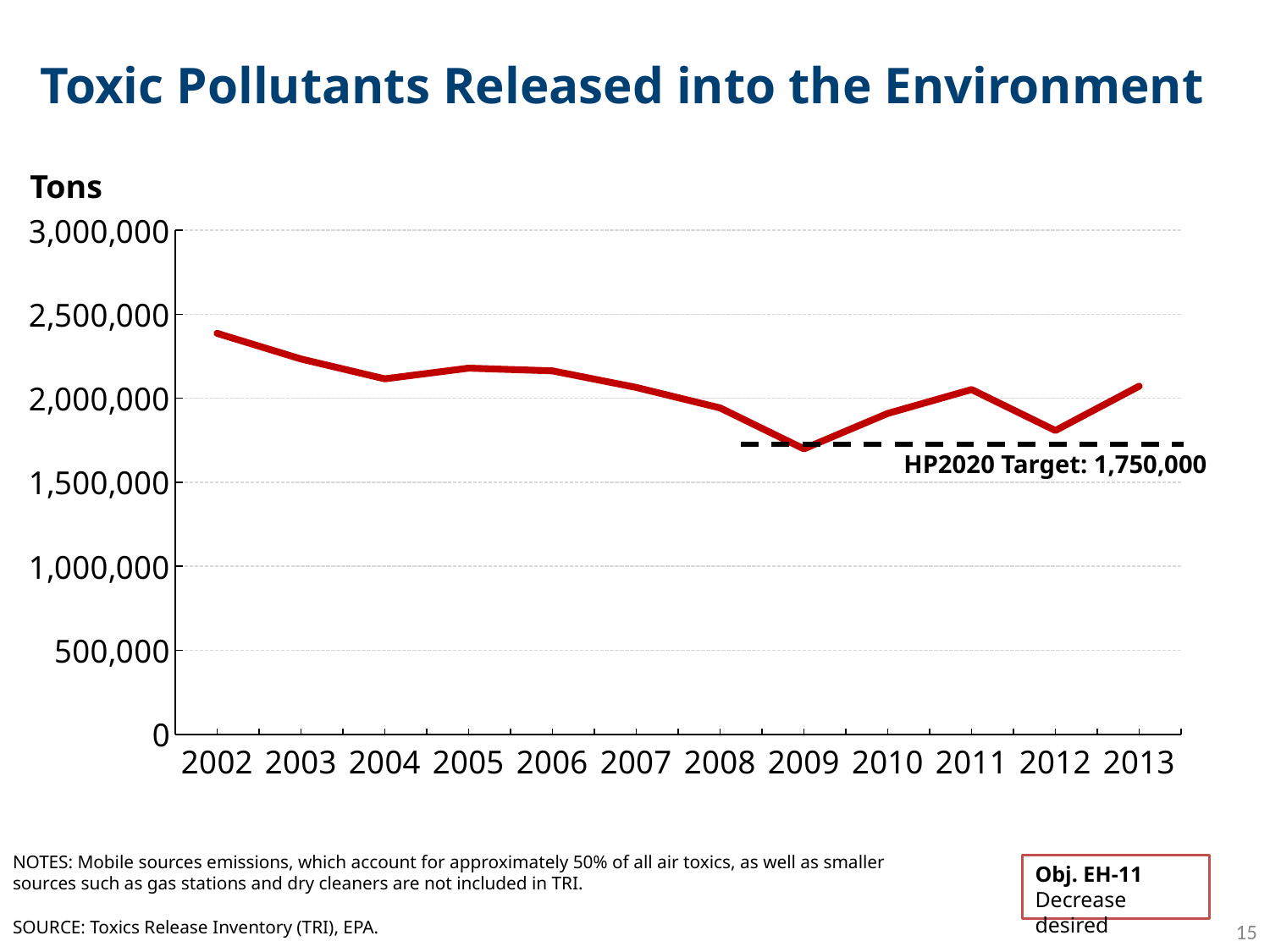
Is the value for 2009 greater or less than 2,000,000 tons? less Which year has the larger value, 2011 or 2012? 2011 What unit is shown on the y axis of the chart? Tons Which year has the lowest value for toxic pollutants released? 2009 What kind of chart is shown on the slide? line chart Which year has the larger value, 2002 or 2009? 2002 Is the value for 2012 greater or less than 2,000,000 tons? less Which year has the highest value for toxic pollutants released? 2002 Do the values rise or fall from 2002 to 2004? fall Is the value for 2002 greater or less than 2,000,000 tons? greater How many years are plotted along the x axis? 12 What is the HP2020 Target value shown on the chart? 1,750,000